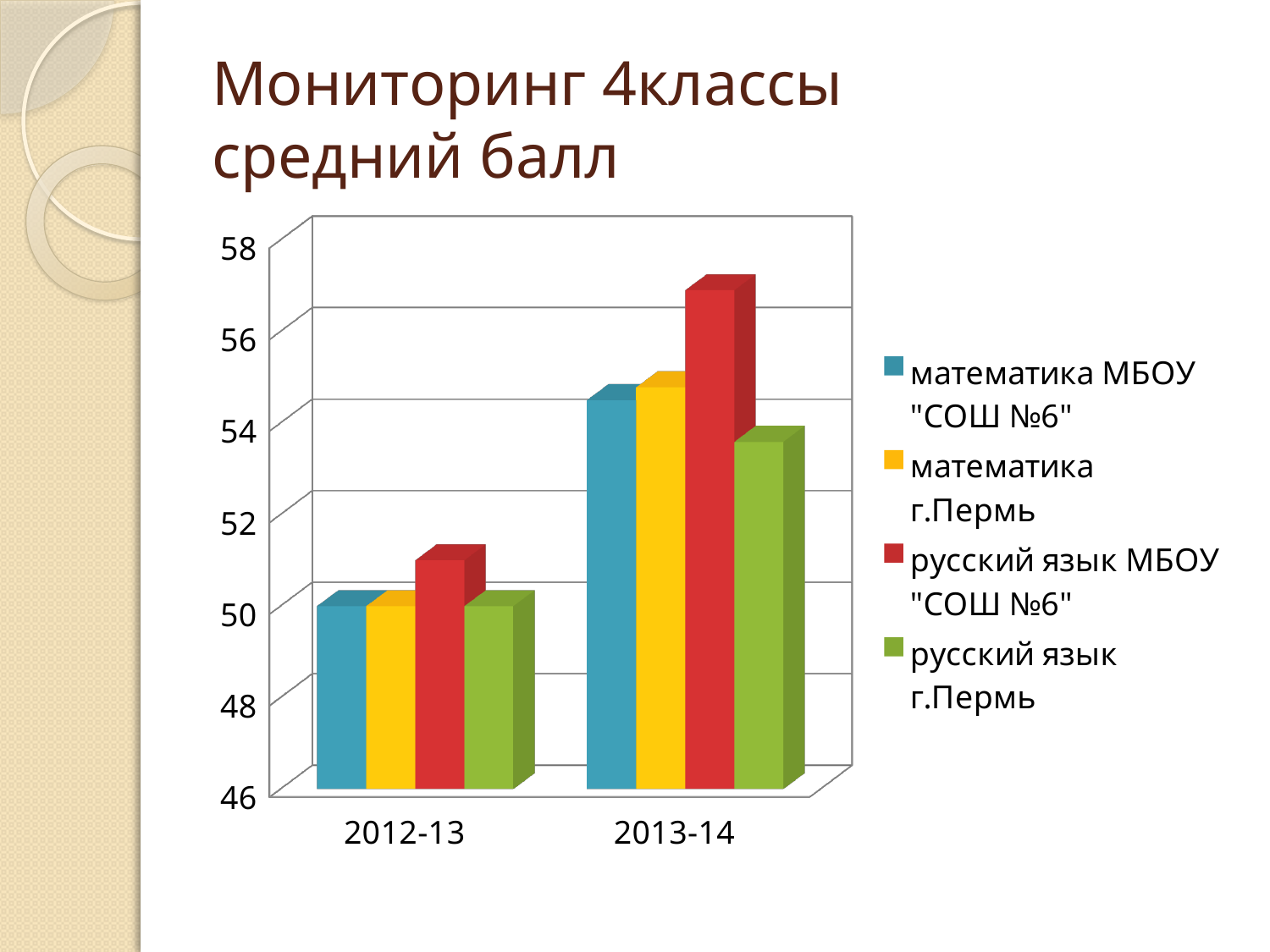
What kind of chart is shown on the slide? bar chart How many series does the legend list? 4 Is the value for русский язык г.Пермь in 2013-14 greater or less than 54? less In 2013-14, which is larger: русский язык МБОУ "СОШ №6" or русский язык г.Пермь? русский язык МБОУ "СОШ №6" Is the value for русский язык МБОУ "СОШ №6" in 2012-13 greater or less than 50? greater Is the value for математика МБОУ "СОШ №6" in 2013-14 greater or less than 54? greater Which series has the highest value for 2012-13? русский язык МБОУ "СОШ №6" How many categories (school years) are shown on the x axis? 2 Which series has the highest value for 2013-14? русский язык МБОУ "СОШ №6" Do the values rise or fall from 2012-13 to 2013-14? rise Which series has the lowest value for 2013-14? русский язык г.Пермь